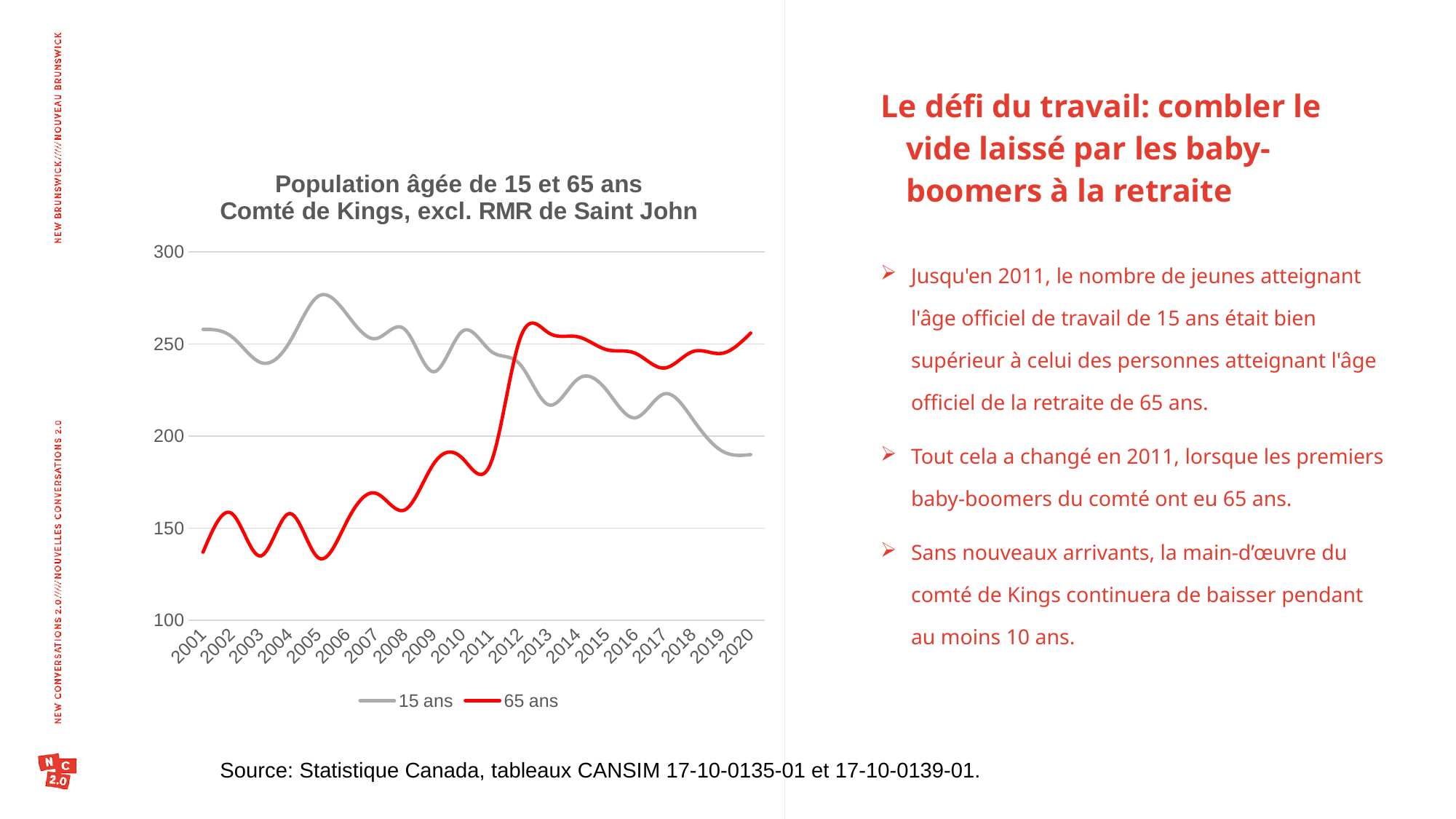
In 2001, which series has the larger value, 15 ans or 65 ans? 15 ans What kind of chart is shown on the slide? line chart Is the value for 65 ans in 2010 greater or less than 200? less How many years are shown on the x axis? 20 Which colour is used for the 65 ans series? red Is the value for 15 ans in 2020 greater or less than 200? less Is the value for 65 ans in 2020 greater or less than 250? greater Overall, does the 15 ans series rise or fall from 2001 to 2020? fall How many series does the legend list? 2 In 2020, which series has the larger value, 15 ans or 65 ans? 65 ans